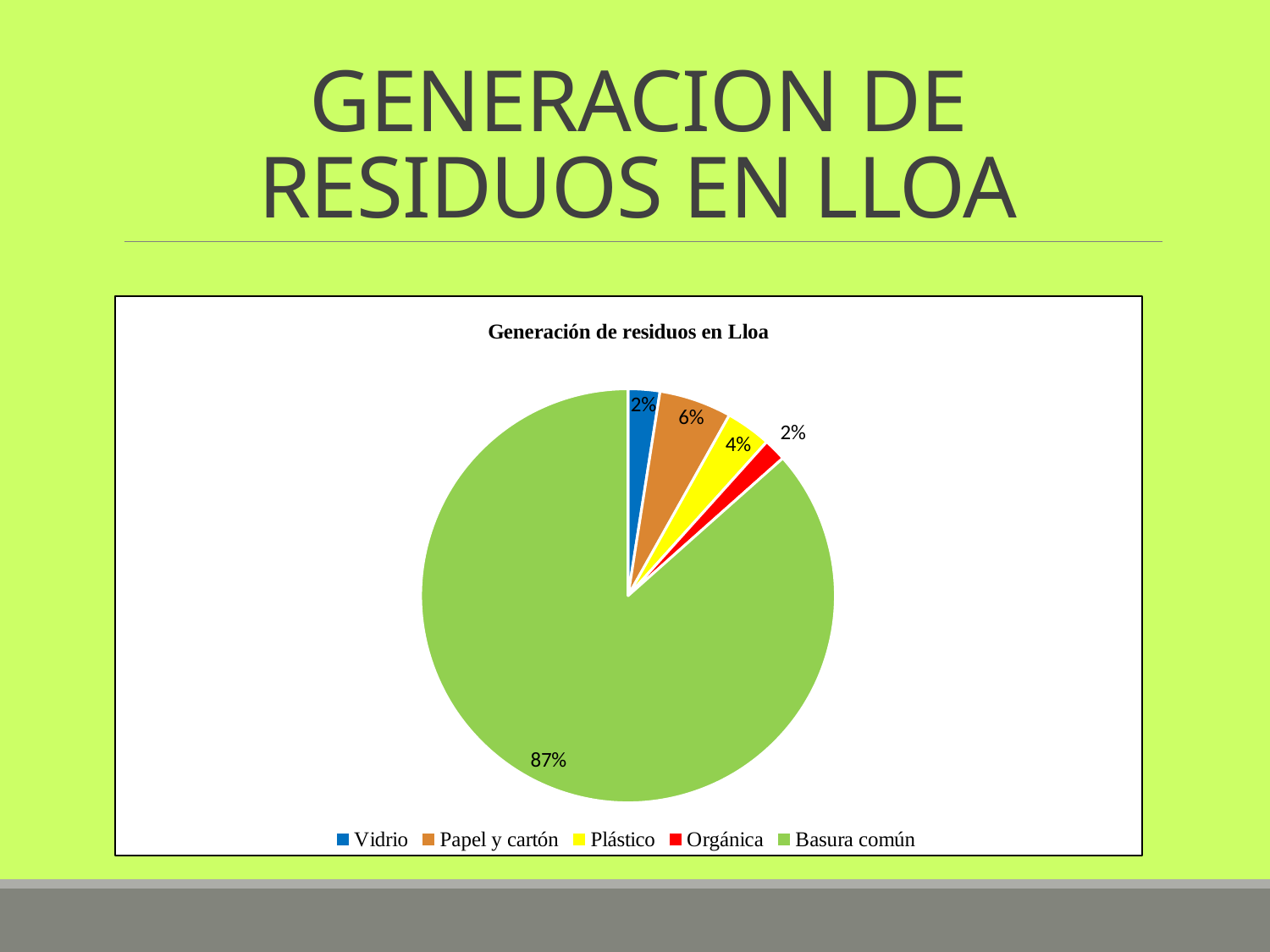
What share of the pie does Plástico represent? 4% What share of the pie does Papel y cartón represent? 6% What is the difference in percentage points between Basura común and Papel y cartón? 81 What is the difference in percentage points between Papel y cartón and Plástico? 2 What share of the pie does Vidrio represent? 2% How many categories are shown in the pie chart? 5 What kind of chart is shown on the slide? Pie chart What is the title of the chart? Generación de residuos en Lloa Which is larger, the share for Papel y cartón or the share for Plástico? Papel y cartón Which category has the largest slice of the pie? Basura común